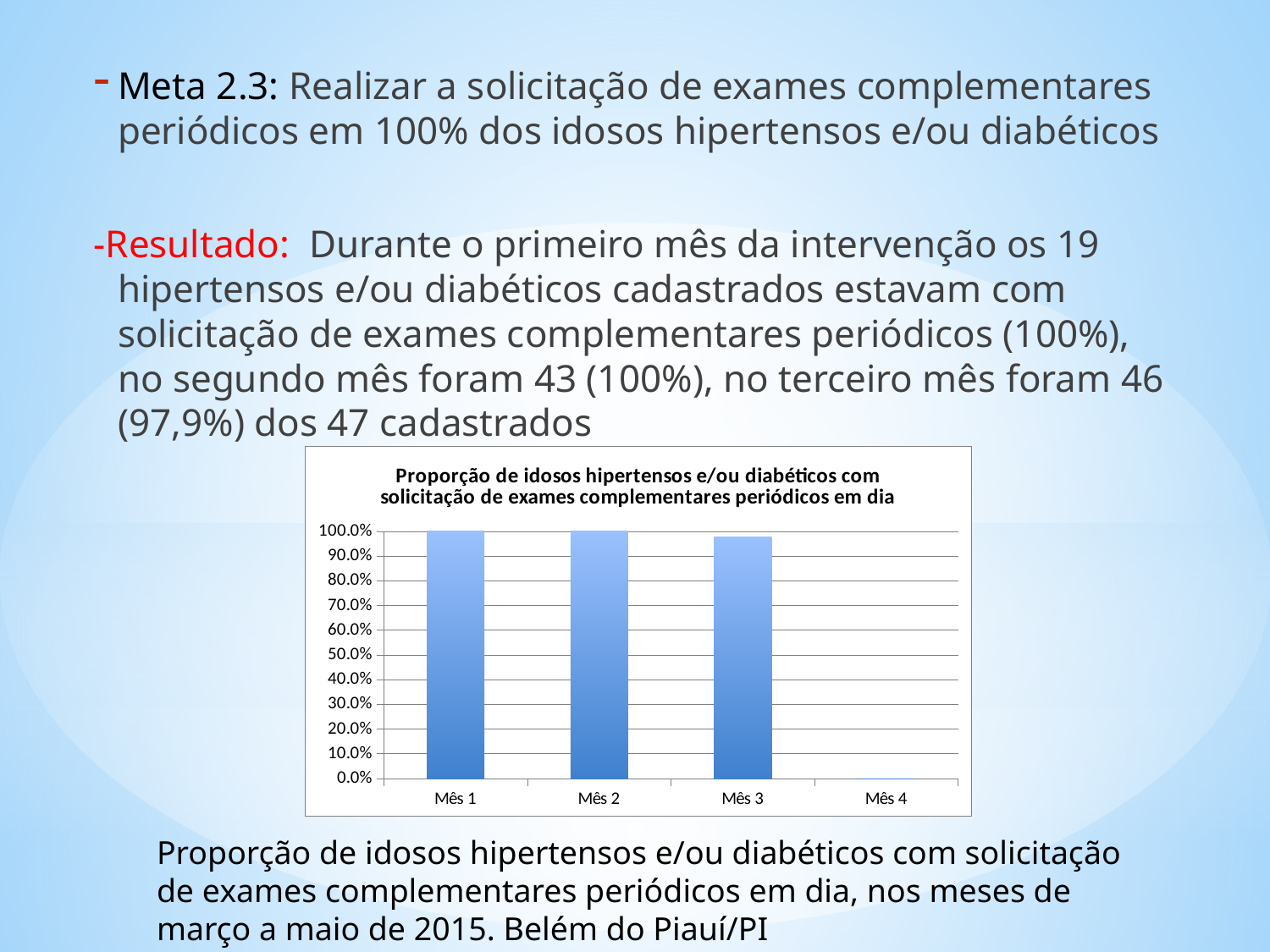
Which is larger, the value for Mês 3 or the value for Mês 4? Mês 3 Which month has the lowest value in the chart? Mês 4 What is the highest tick value shown on the y axis of the chart? 100.0% What is the value for Mês 1 in the chart? 100.0% What kind of chart is shown on the slide? bar chart Is the value for Mês 4 greater or less than 10.0%? less What is the title of the chart? Proporção de idosos hipertensos e/ou diabéticos com solicitação de exames complementares periódicos em dia How many categories (months) are shown on the x axis of the chart? 4 Is the value for Mês 3 greater or less than 90.0%? greater Which is larger, the value for Mês 1 or the value for Mês 4? Mês 1 What is the value for Mês 2 in the chart? 100.0% Do the values rise or fall from Mês 3 to Mês 4? fall